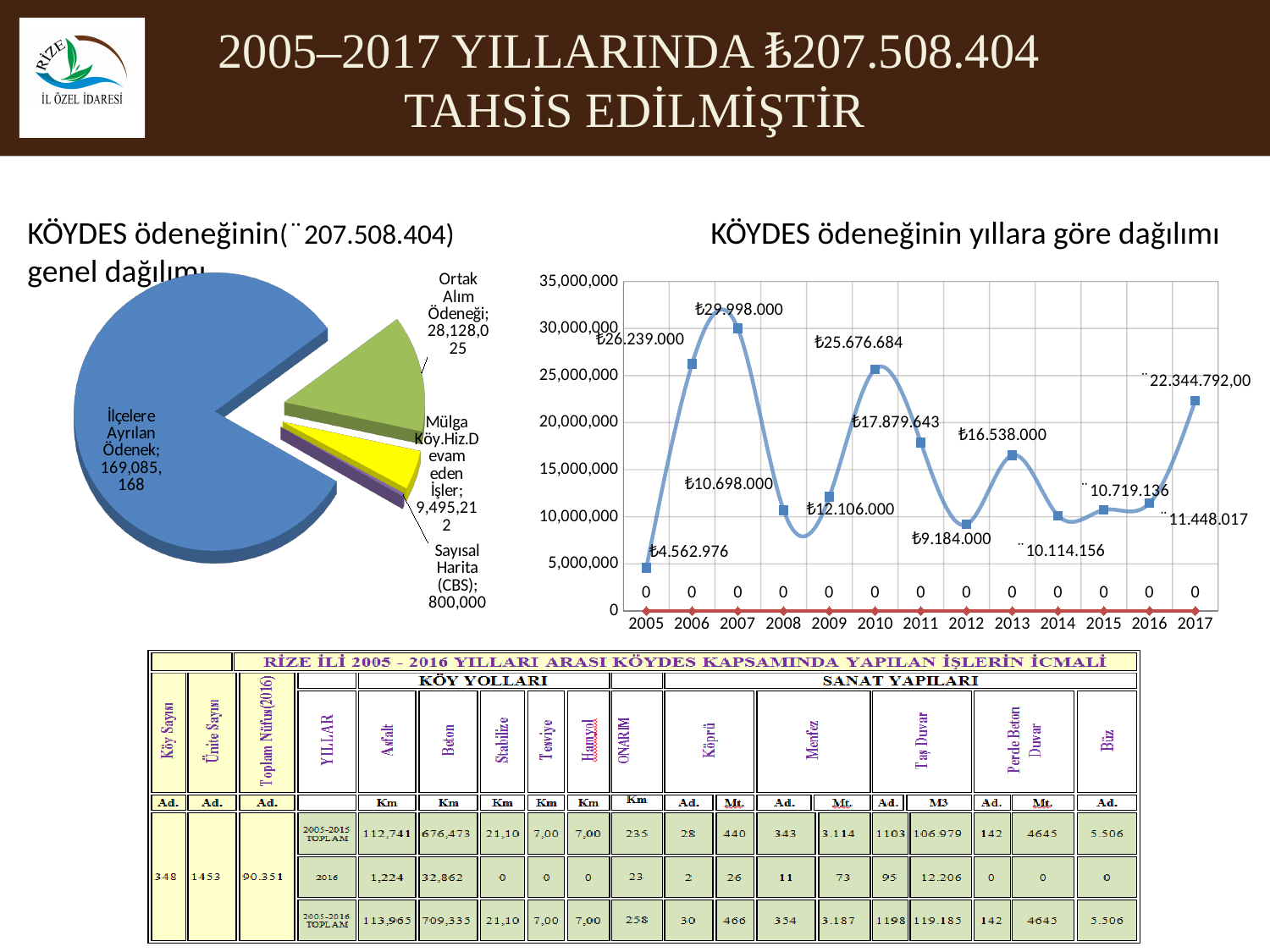
In the line chart 'KÖYDES ödeneğinin yıllara göre dağılımı', how many years are shown on the x axis? 13 What kind of chart is the chart on the left titled 'KÖYDES ödeneğinin genel dağılımı'? pie chart In the line chart 'KÖYDES ödeneğinin yıllara göre dağılımı', is the value for 2010 greater or less than 25,000,000? greater In the line chart 'KÖYDES ödeneğinin yıllara göre dağılımı', which year has the highest value? 2007 In the line chart 'KÖYDES ödeneğinin yıllara göre dağılımı', does the value rise or fall from 2016 to 2017? rise In the line chart 'KÖYDES ödeneğinin yıllara göre dağılımı', what is the value for 2007? ₺29.998.000 In the pie chart on the left, which slice is the largest? İlçelere Ayrılan Ödenek In the line chart 'KÖYDES ödeneğinin yıllara göre dağılımı', what is the value for 2005? ₺4.562.976 In the line chart 'KÖYDES ödeneğinin yıllara göre dağılımı', which is larger, the value for 2011 or the value for 2013? 2011 In the line chart 'KÖYDES ödeneğinin yıllara göre dağılımı', what is the difference between the 2007 value and the 2006 value? ₺3.759.000 In the pie chart on the left, what is the value for 'Ortak Alım Ödeneği'? 28,128,025 In the line chart 'KÖYDES ödeneğinin yıllara göre dağılımı', which year has the lowest value? 2005